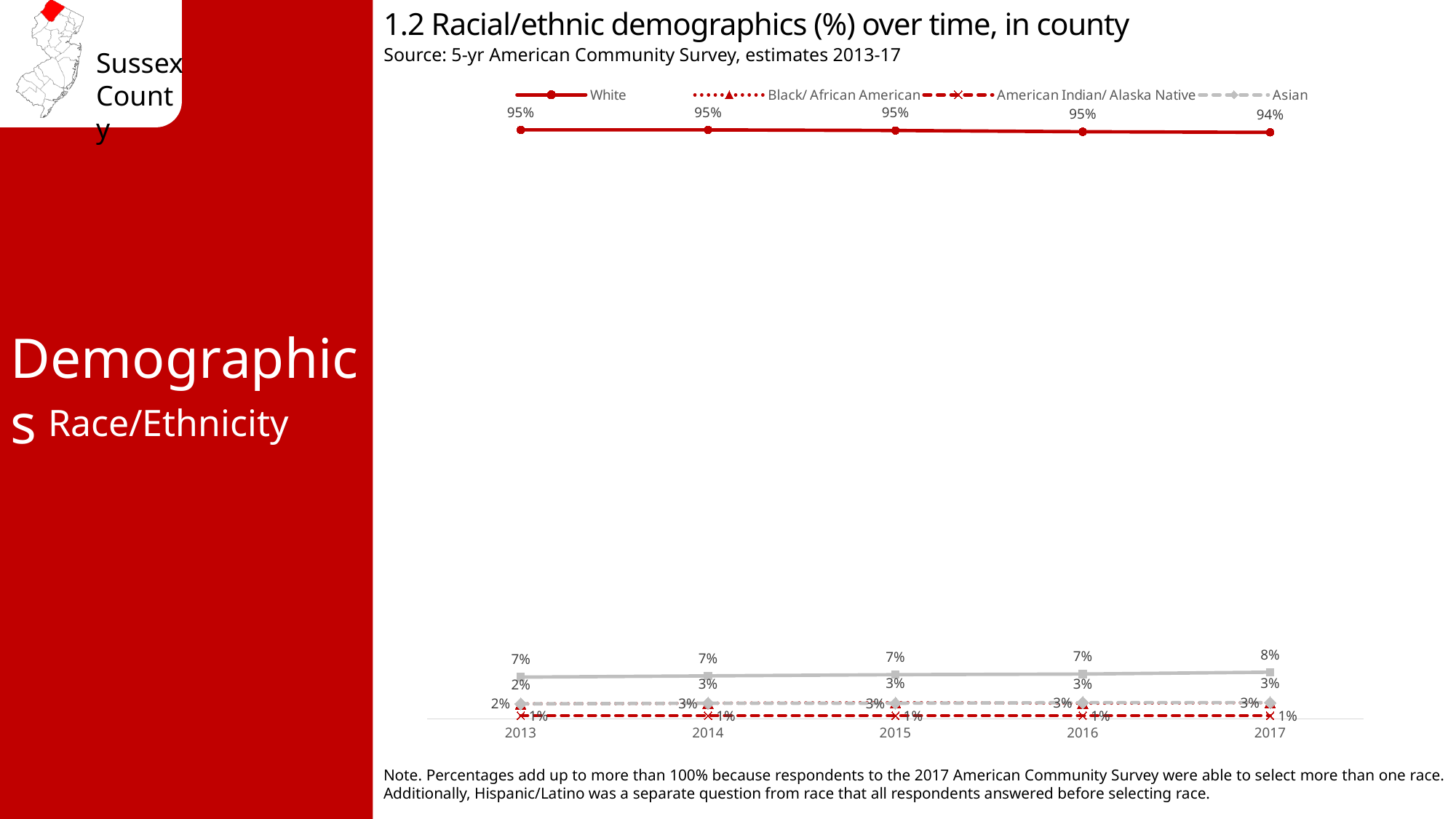
What is the value for White in 2013? 95% What is the difference between the White value in 2013 and in 2017? 1% Which is larger in 2016, the value for White or the value for American Indian/ Alaska Native? White Does the White series rise or fall from 2013 to 2017? fall What type of chart is shown on the slide? line chart What is the source cited under the chart title? 5-yr American Community Survey, estimates 2013-17 What is the value for Asian in 2013? 2% What is the value for White in 2017? 94% What is the value for Black/ African American in 2017? 3% What is the value for American Indian/ Alaska Native in 2015? 1% How many years are shown on the x axis? 5 In which year is the value for White lowest? 2017